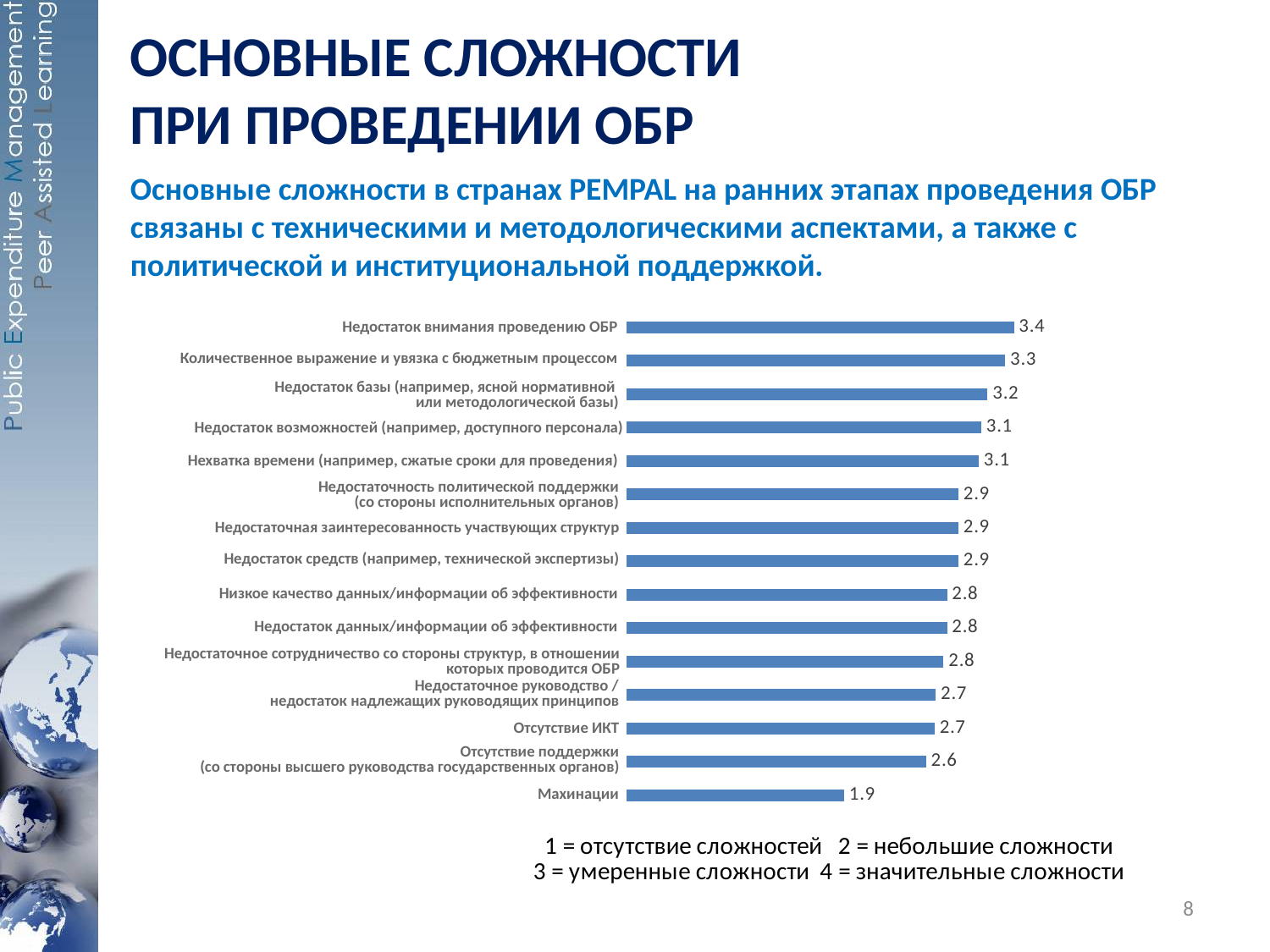
What is the value for "Махинации"? 1.9 What is the value for "Недостаток внимания проведению ОБР"? 3.4 What is the value for "Нехватка времени (например, сжатые сроки для проведения)"? 3.1 According to the scale note below the chart, what does a value of 4 mean? значительные сложности Do the bar values increase or decrease going from the top of the chart to the bottom? Decrease Which category has the lowest value? Махинации Which category has the highest value? Недостаток внимания проведению ОБР Which is larger: the value for "Отсутствие ИКТ" or the value for "Махинации"? Отсутствие ИКТ What is the difference between the values for "Недостаток внимания проведению ОБР" and "Махинации"? 1.5 What is the value for "Отсутствие ИКТ"? 2.7 How many categories are plotted in the chart? 15 What kind of chart is shown on the slide? Bar chart